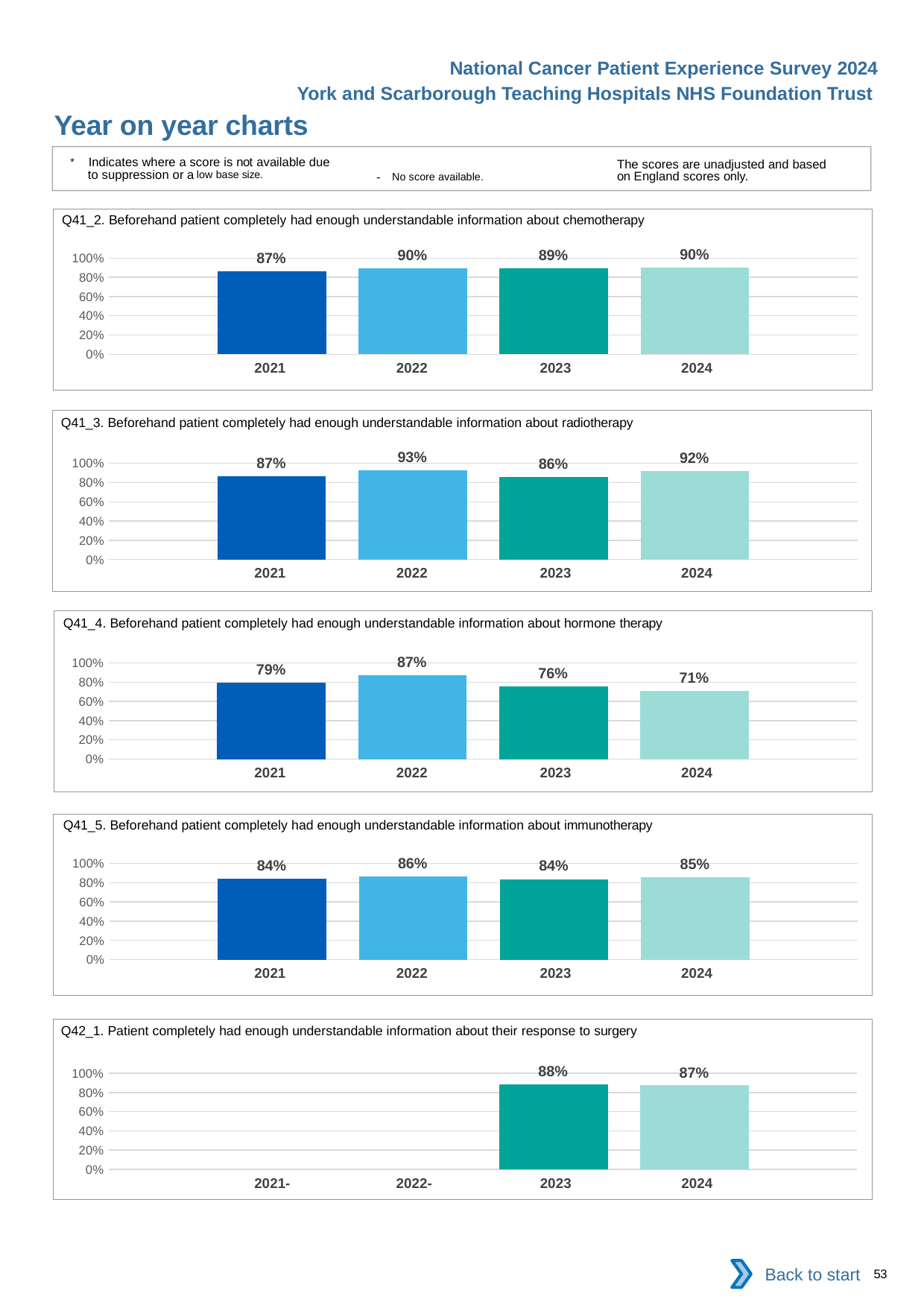
In the Q41_2 chart about chemotherapy, what is the value for 2023? 89% In the Q41_4 chart about hormone therapy, do the values rise or fall from 2022 to 2024? fall How many charts are shown on the slide? 5 In the Q42_1 chart about response to surgery, how many years have a bar plotted? 2 In the Q42_1 chart about response to surgery, what is the value for 2023? 88% In the Q41_3 chart about radiotherapy, which year has the highest value? 2022 What kind of chart is used for Q41_2 about chemotherapy? bar chart In the Q41_5 chart about immunotherapy, what is the value for 2022? 86% In the Q41_5 chart about immunotherapy, is the 2024 value larger or smaller than the 2021 value? larger In the Q41_4 chart about hormone therapy, which year has the lowest value? 2024 In the Q41_3 chart about radiotherapy, what is the value for 2024? 92% In the Q41_4 chart about hormone therapy, what is the difference between the 2022 and 2024 values? 16 percentage points